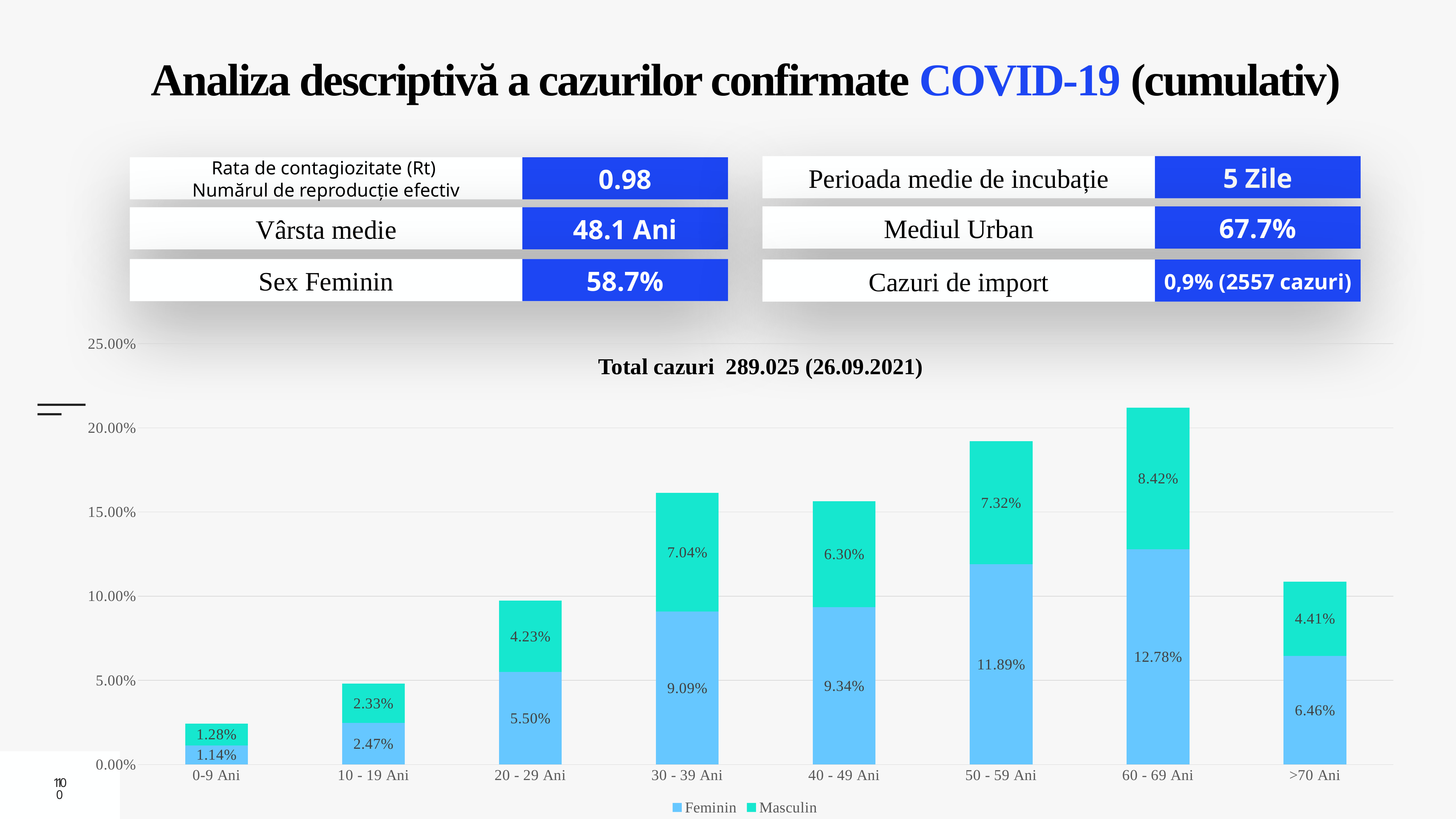
What is the Feminin value for the 60 - 69 Ani age group? 12.78% What kind of chart is shown on the slide? stacked bar chart What is the difference between the Feminin and Masculin values for the 50 - 59 Ani age group? 4.57% What is the total of the stacked bar for the 20 - 29 Ani age group? 9.73% Is the total stacked bar for the 60 - 69 Ani age group greater or less than 20.00%? greater Which is larger for the 0-9 Ani age group, the Feminin value or the Masculin value? Masculin What is the Feminin value for the >70 Ani age group? 6.46% Which age group has the highest Masculin value? 60 - 69 Ani Which age group has the lowest Feminin value? 0-9 Ani How many series does the chart legend list? 2 How many age groups are shown on the x axis of the chart? 8 What is the Masculin value for the 30 - 39 Ani age group? 7.04%